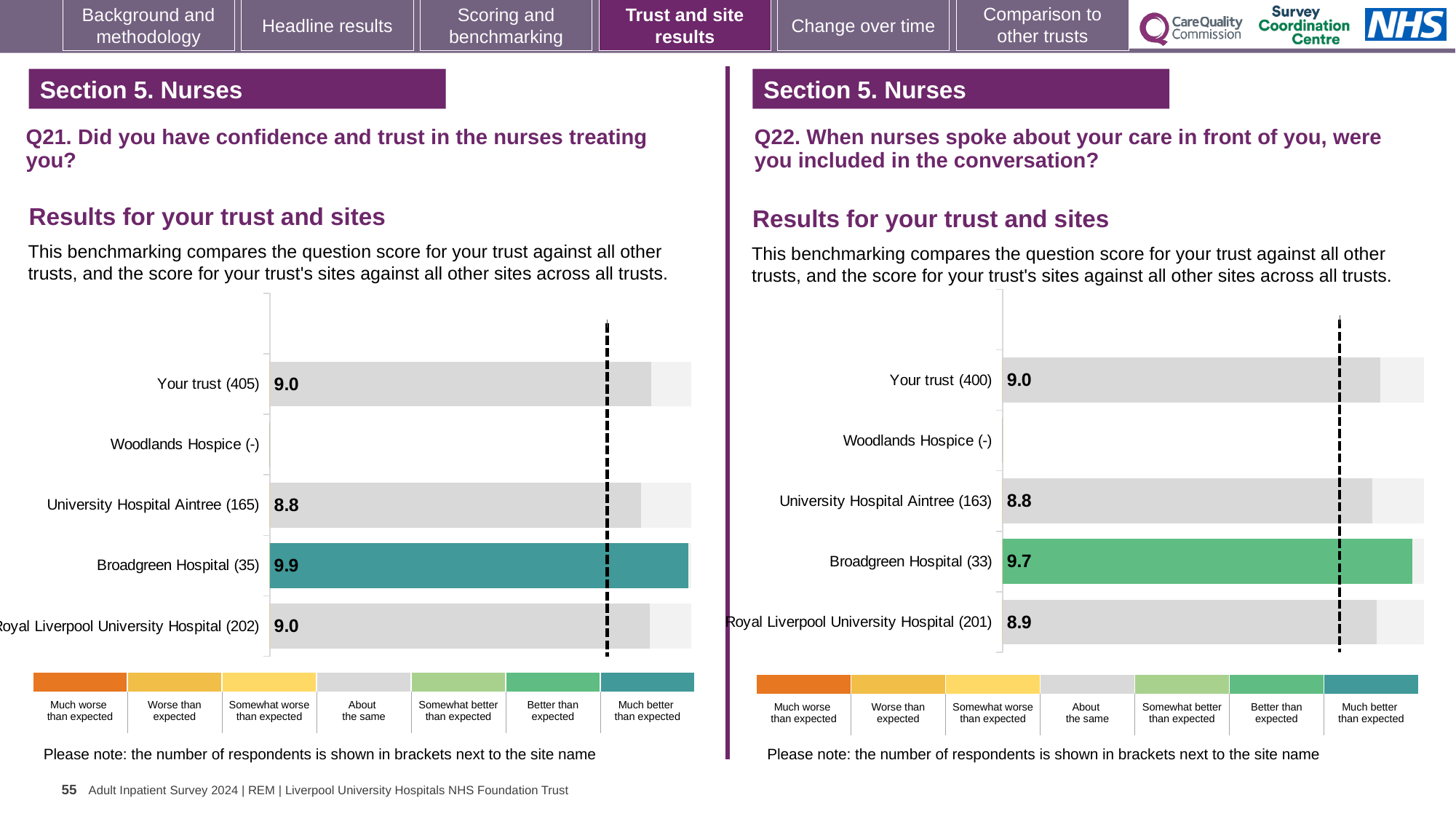
In the Q22 chart, what is the difference between the scores for Broadgreen Hospital and Royal Liverpool University Hospital? 0.8 In the Q21 chart, which site has the highest score? Broadgreen Hospital In the Q22 chart, which has the higher score, Your trust or Royal Liverpool University Hospital? Your trust In the Q21 chart, what is the score for Broadgreen Hospital? 9.9 In the Q22 chart, which site has the lowest score? University Hospital Aintree In the Q21 chart, which benchmark category does the colour of the Broadgreen Hospital bar correspond to? Much better than expected What type of chart is used for the Q22 results? Bar chart In the Q22 chart, what is the score for Your trust? 9.0 How many site or trust labels are listed on the vertical axis of the Q21 chart? 5 In the Q22 chart, what is the score for Royal Liverpool University Hospital? 8.9 In the Q21 chart, what is the score for University Hospital Aintree? 8.8 In the Q21 chart, what is the difference between the scores for Broadgreen Hospital and University Hospital Aintree? 1.1